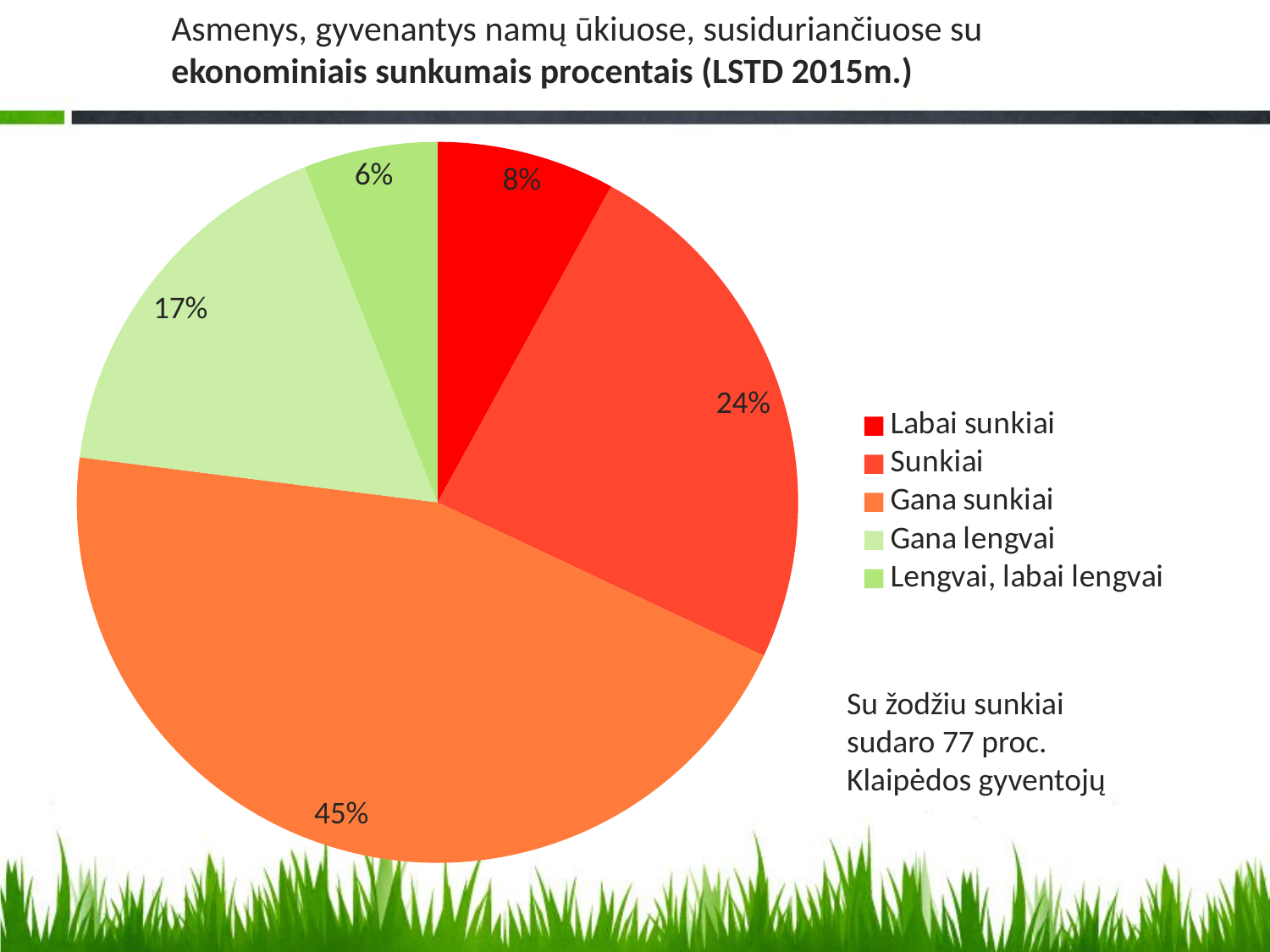
How many categories does the legend list? 5 What percentage is shown for the 'Lengvai, labai lengvai' slice? 6% Which category has the largest share of the pie? Gana sunkiai What colour is the 'Labai sunkiai' slice? red What kind of chart is shown on the slide? pie chart What percentage is shown for the 'Gana sunkiai' slice? 45% What percentage is shown for the 'Labai sunkiai' slice? 8% Which is larger, the share for 'Gana lengvai' or the share for 'Labai sunkiai'? Gana lengvai What percentage is shown for the 'Sunkiai' slice? 24% What is the difference in percentage points between 'Gana sunkiai' and 'Sunkiai'? 21 What percentage is shown for the 'Gana lengvai' slice? 17% Which category has the smallest share of the pie? Lengvai, labai lengvai